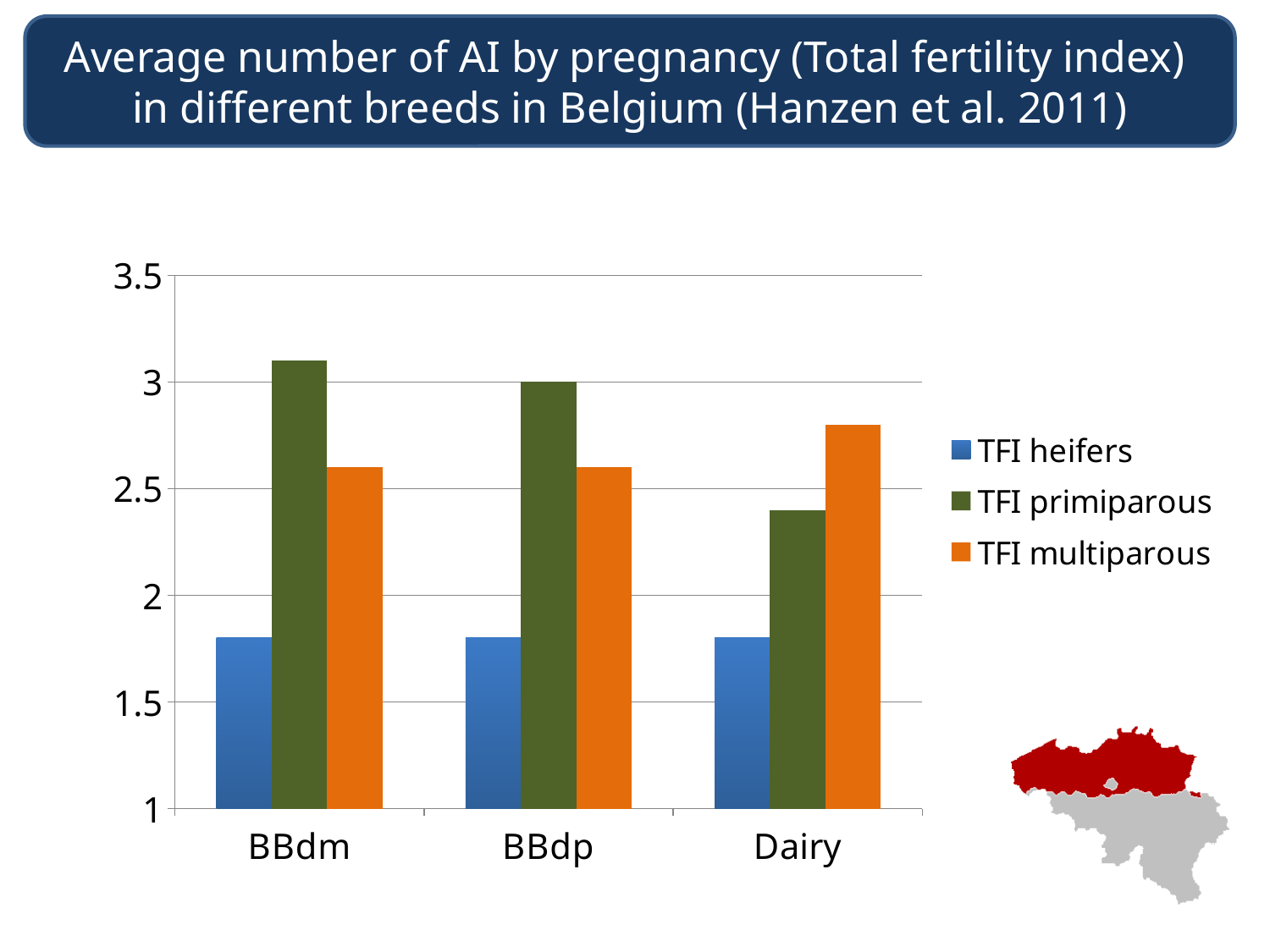
How many series does the legend list? 3 What is the TFI primiparous value for BBdp? 3 Which colour represents TFI multiparous in the legend? orange Is the TFI multiparous value for Dairy greater or less than 2.5? greater Which breed has the lowest TFI primiparous value? Dairy Is the TFI heifers value for Dairy greater or less than 2? less How many breed categories are shown on the x axis? 3 For Dairy, which is larger: TFI primiparous or TFI multiparous? TFI multiparous What kind of chart is shown on the slide? bar chart Is the TFI primiparous value for BBdm greater or less than 3? greater Which breed has the highest TFI multiparous value? Dairy